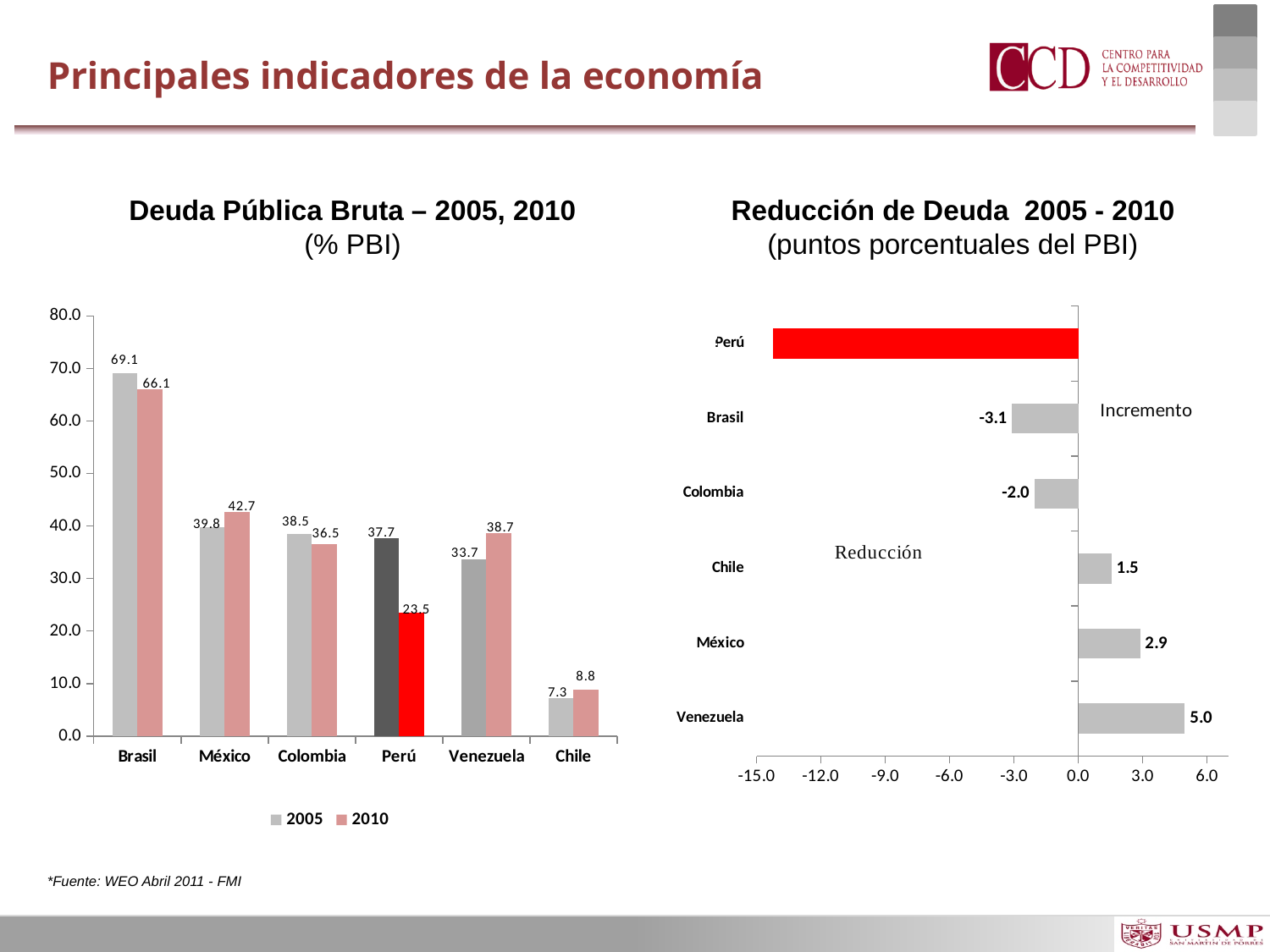
In the 'Deuda Pública Bruta – 2005, 2010' chart, which country has the highest 2010 value? Brasil In the 'Reducción de Deuda 2005 - 2010' chart, what is the value for Brasil? -3.1 How many series does the legend of the 'Deuda Pública Bruta – 2005, 2010' chart list? 2 In the 'Deuda Pública Bruta – 2005, 2010' chart, what is the difference between the 2005 and 2010 values for Perú? 14.2 In the 'Deuda Pública Bruta – 2005, 2010' chart, what is the 2010 value for Perú? 23.5 In the 'Deuda Pública Bruta – 2005, 2010' chart, what is the 2005 value for Brasil? 69.1 How many countries are shown in the 'Deuda Pública Bruta – 2005, 2010' chart? 6 In the 'Reducción de Deuda 2005 - 2010' chart, is the value for Perú greater or less than -12.0? less In the 'Reducción de Deuda 2005 - 2010' chart, what is the value for Venezuela? 5.0 In the 'Deuda Pública Bruta – 2005, 2010' chart, is the 2010 value for Venezuela larger or smaller than its 2005 value? larger In the 'Deuda Pública Bruta – 2005, 2010' chart, which country has the lowest 2005 value? Chile What kind of chart is the 'Reducción de Deuda 2005 - 2010' chart? bar chart